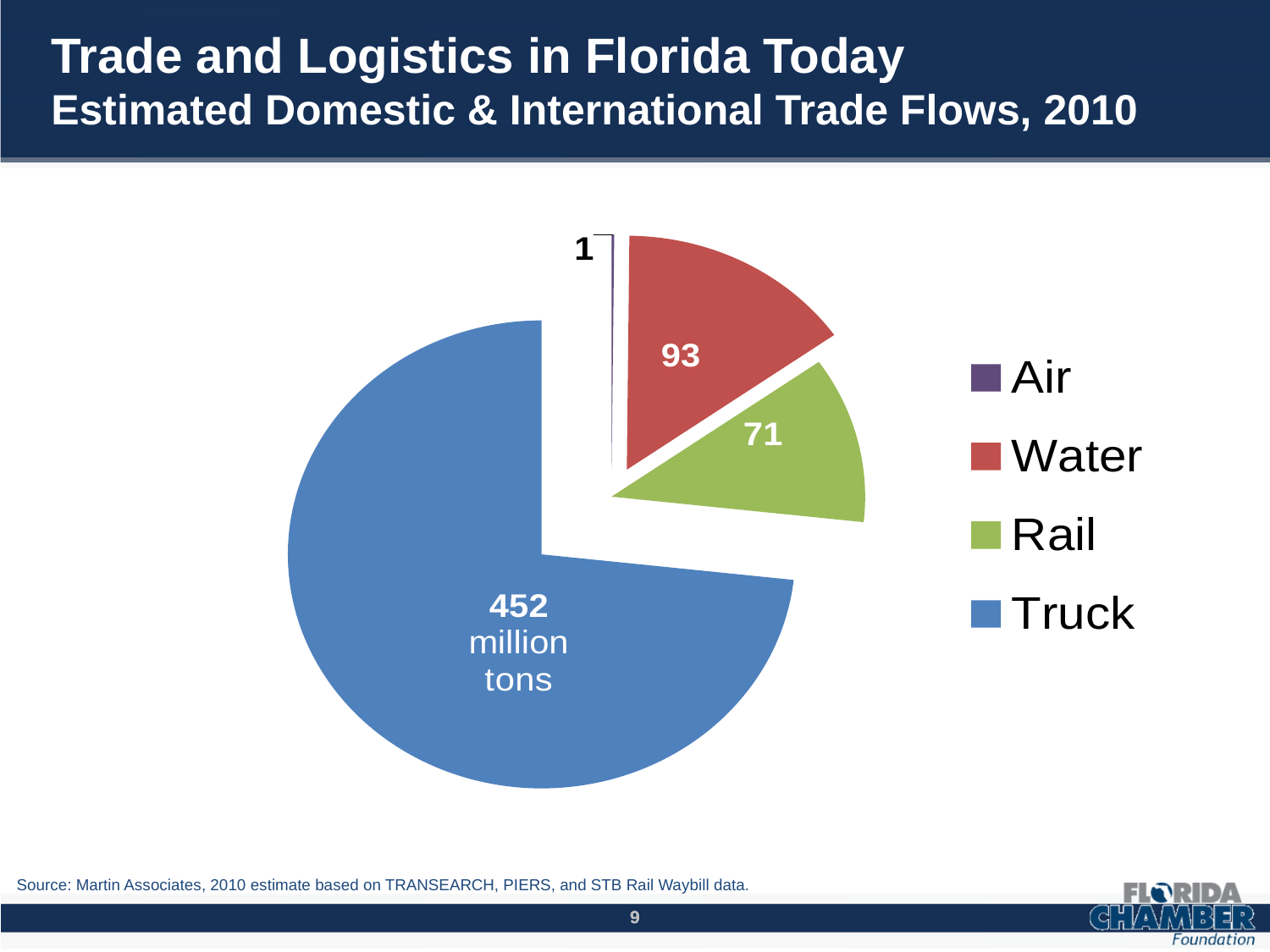
What is the difference between the Water value and the Rail value? 22 What kind of chart is shown on the slide? Pie chart Which is larger, the Water slice or the Rail slice? Water How many slices does the pie chart have? 4 What is the value shown for Truck in the pie chart? 452 million tons What is the value shown for Water in the pie chart? 93 Which mode has the smallest slice of the pie chart? Air What colour is the Truck slice in the pie chart? Blue Which mode has the largest slice of the pie chart? Truck What is the value shown for Rail in the pie chart? 71 How many entries does the legend list? 4 What is the value shown for Air in the pie chart? 1